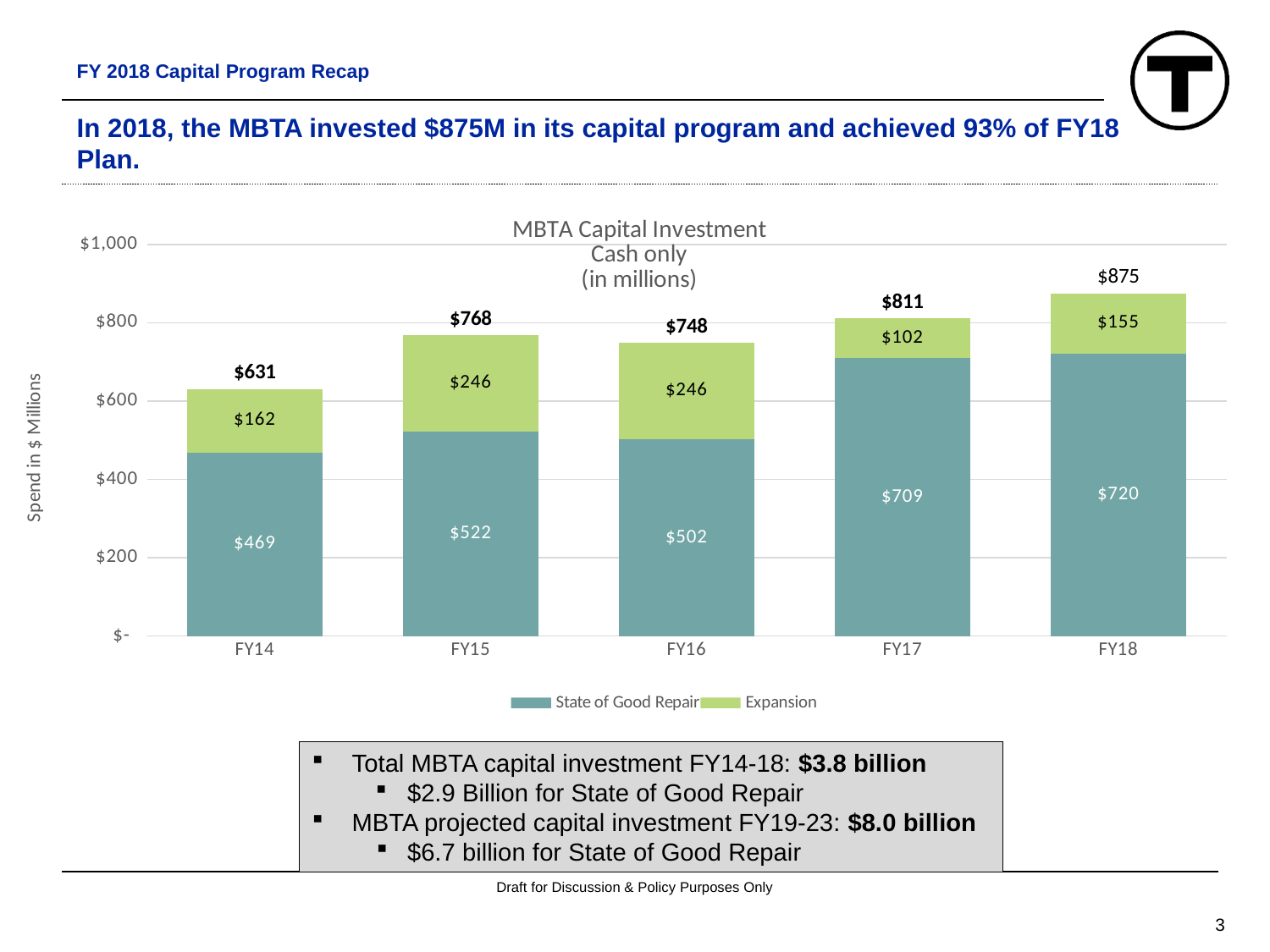
What is the label on the y axis? Spend in $ Millions What is the State of Good Repair value for FY16? $502 Which is larger, the Expansion value for FY15 or for FY17? FY15 What is the total capital investment shown for FY15? $768 Is the State of Good Repair value for FY17 greater or less than $600? greater What kind of chart is shown? Stacked bar chart Which fiscal year has the highest total capital investment? FY18 How many series does the legend list? 2 What is the Expansion value for FY18? $155 How many fiscal years are shown on the x axis? 5 What is the difference between the FY18 and FY17 totals? $64 Which fiscal year has the lowest State of Good Repair value? FY14